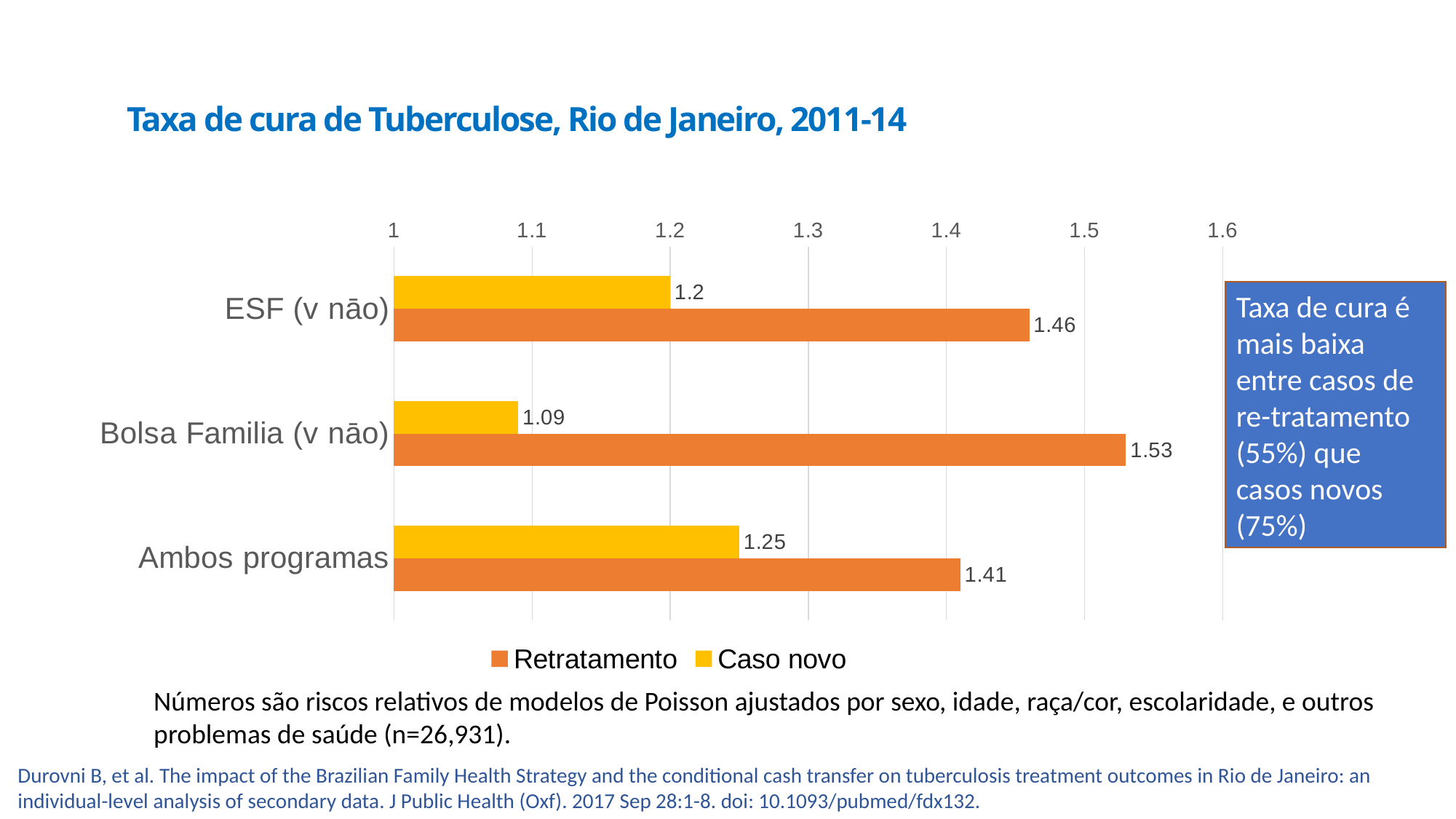
What is the Caso novo value for Bolsa Familia (v não)? 1.09 What is the difference between the Retratamento and Caso novo values for Bolsa Familia (v não)? 0.44 Which category has the highest Retratamento value? Bolsa Familia (v não) What is the Retratamento value for ESF (v não)? 1.46 Which is larger for Ambos programas: the Retratamento value or the Caso novo value? Retratamento How many categories are shown on the chart? 3 Is the Retratamento value for Ambos programas greater or less than 1.5? less What kind of chart is shown on the slide? Bar chart What is the Caso novo value for Ambos programas? 1.25 What is the title of the chart? Taxa de cura de Tuberculose, Rio de Janeiro, 2011-14 How many series does the legend list? 2 Which category has the lowest Caso novo value? Bolsa Familia (v não)